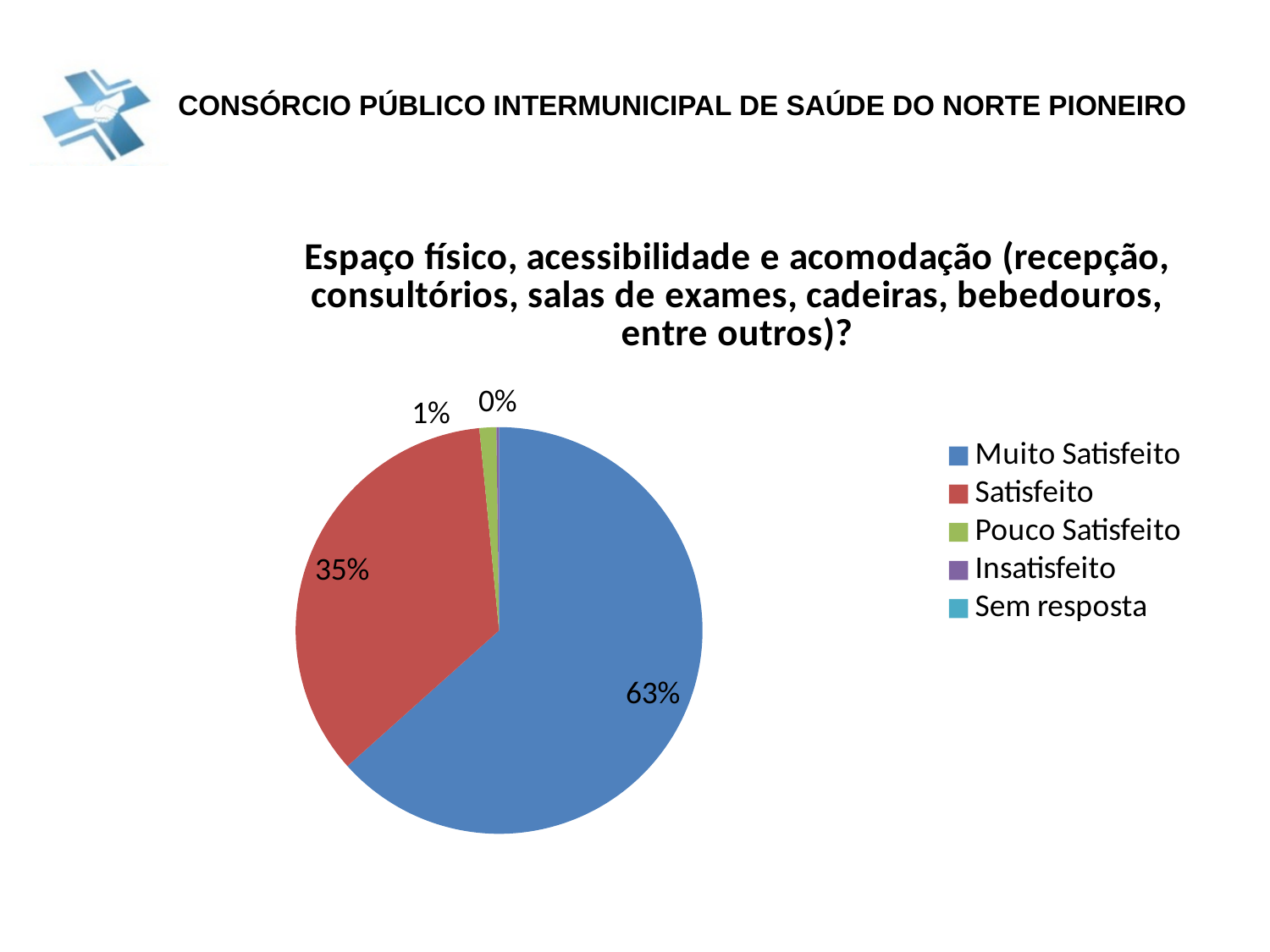
Does the Muito Satisfeito slice represent more or less than half of the pie? More What colour is used for the Muito Satisfeito slice? Blue What share of the pie does the Satisfeito slice represent? 35% What percentage of the pie chart is labelled for Muito Satisfeito? 63% What is the difference in percentage points between the Muito Satisfeito and Satisfeito slices? 28 percentage points What percentage is shown for the Satisfeito slice? 35% Which slice is larger, Muito Satisfeito or Satisfeito? Muito Satisfeito What kind of chart is shown on the slide? Pie chart How many categories does the legend list? 5 What percentage is shown for the Pouco Satisfeito slice? 1% Which slice is larger, Satisfeito or Pouco Satisfeito? Satisfeito Which category has the largest slice of the pie? Muito Satisfeito